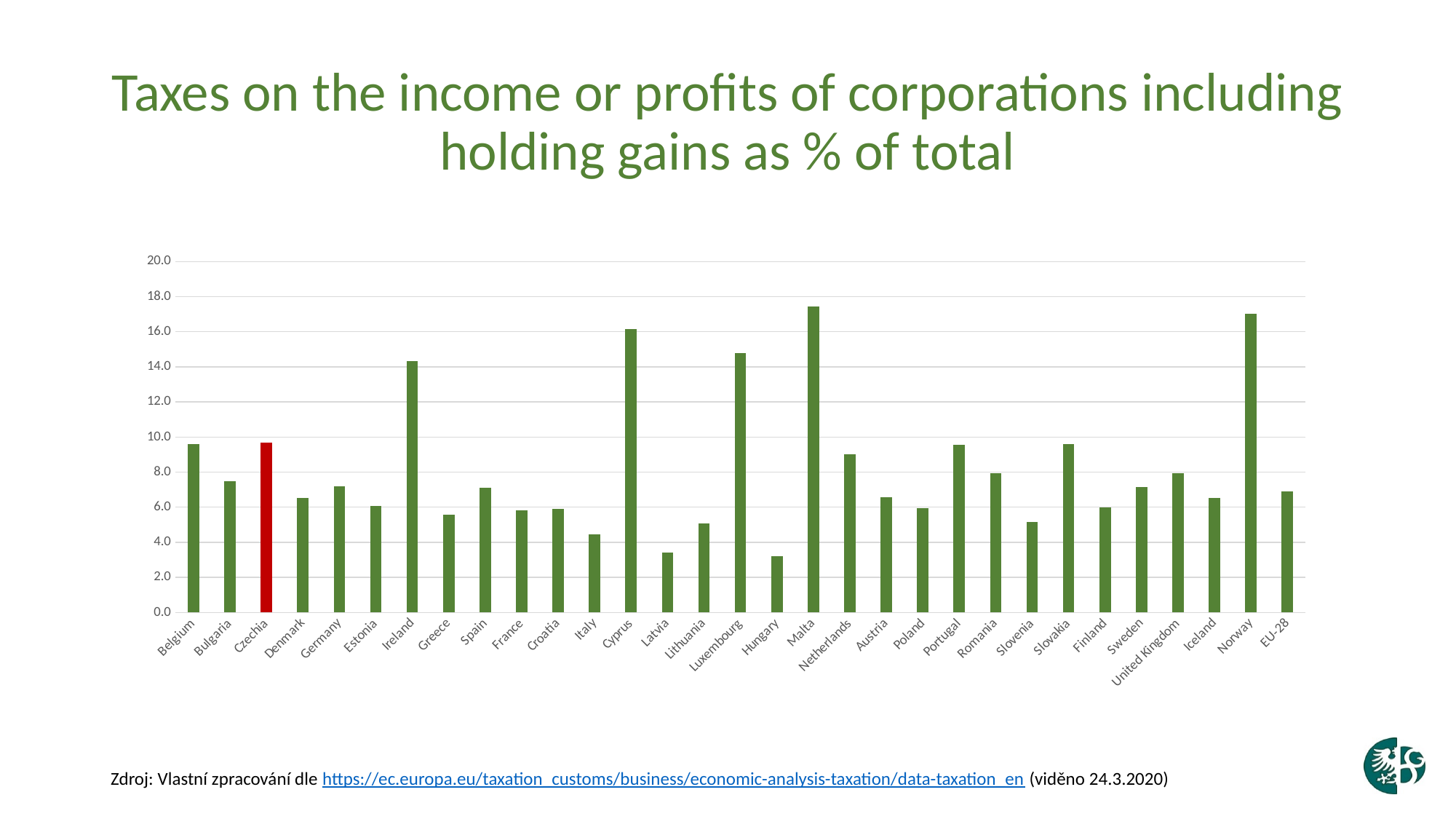
Is the value for Hungary greater or less than 4.0? less Is the value for Norway greater or less than 16.0? greater Which has the larger value, Cyprus or Ireland? Cyprus How many countries/categories are shown on the x axis of the chart? 31 Which has the larger value, Czechia or Bulgaria? Czechia Is the value for Ireland greater or less than 12.0? greater What kind of chart is shown on the slide? bar chart Which country's bar is highlighted in red? Czechia Which has the larger value, Italy or Hungary? Italy